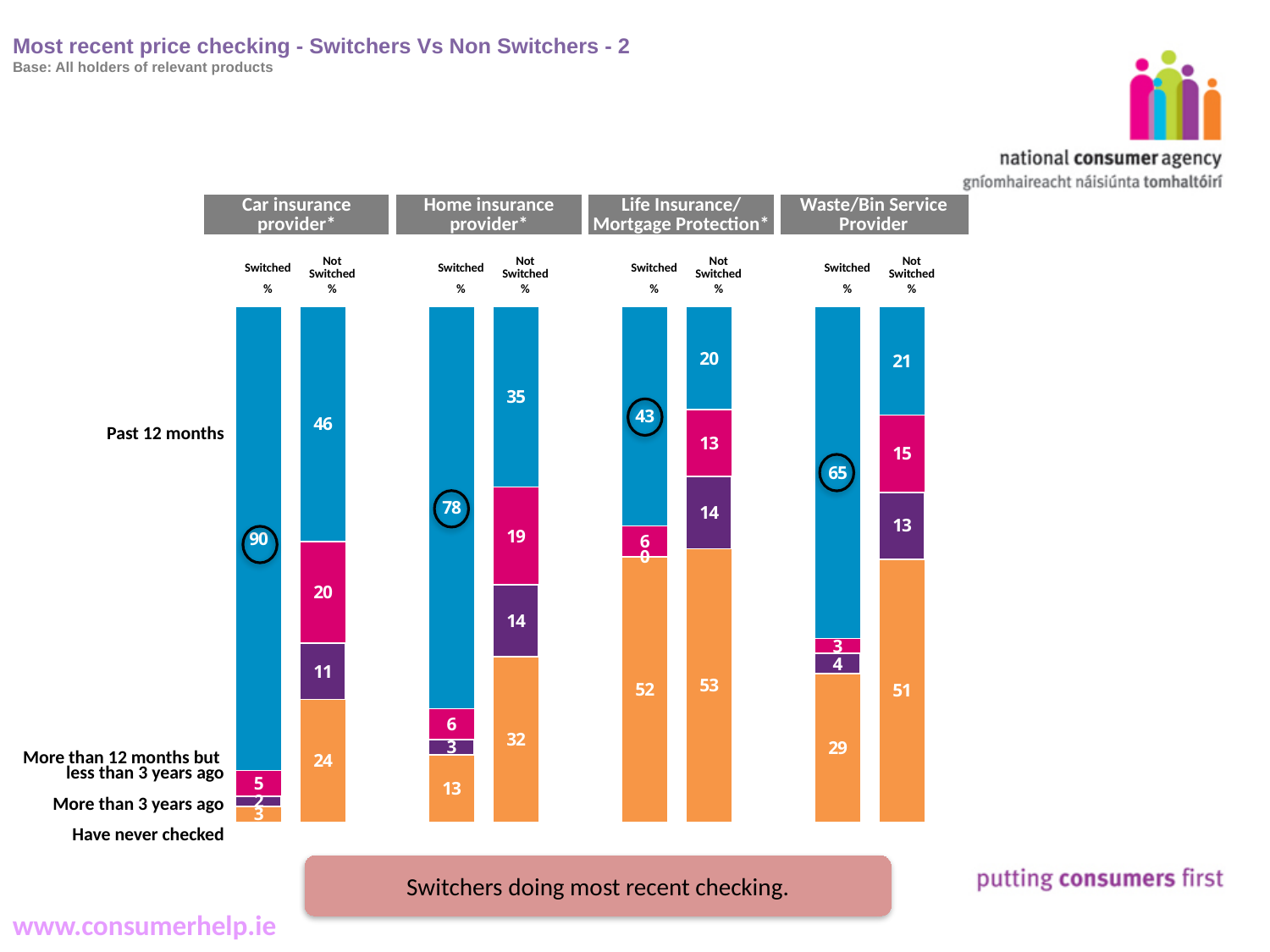
What is the difference between the past 12 months share for home insurance switchers and home insurance non-switchers? 43 What percentage of Life Insurance/Mortgage Protection switchers checked prices more than 3 years ago? 0 Which product's switchers have the lowest share checking prices in the past 12 months? Life Insurance/Mortgage Protection What is the total of the segments in the car insurance Not Switched bar? 101 Which is larger: the share of Waste/Bin Service switchers who have never checked, or the share of Waste/Bin Service non-switchers who have never checked? Not Switched What percentage of home insurance non-switchers have never checked prices? 32 What percentage of car insurance switchers checked prices in the past 12 months? 90 How many price-checking time periods (segments) are shown in each bar? 4 Which product's switchers have the highest share checking prices in the past 12 months? Car insurance provider What percentage of Waste/Bin Service Provider non-switchers checked prices in the past 12 months? 21 How many product categories are shown in the chart? 4 What type of chart is shown on the slide? Stacked bar chart